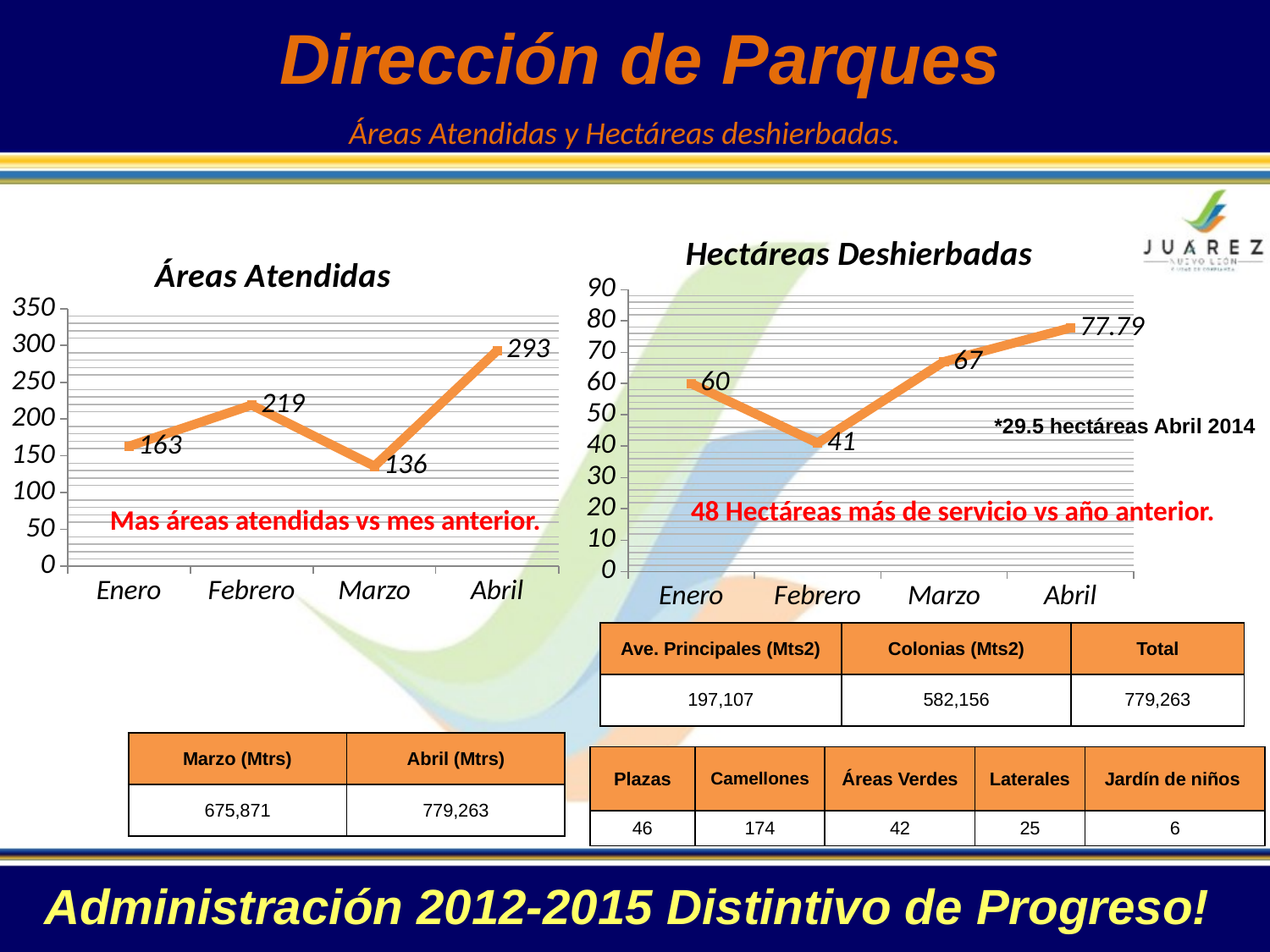
What kind of chart is the 'Áreas Atendidas' chart? Line chart In the 'Hectáreas Deshierbadas' chart, which is larger, the value for Enero or the value for Marzo? Marzo In the 'Áreas Atendidas' chart, which month has the highest value? Abril In the 'Áreas Atendidas' chart, what is the value for Marzo? 136 In the 'Áreas Atendidas' chart, which month has the lowest value? Marzo In the 'Áreas Atendidas' chart, how many months are plotted? 4 In the 'Hectáreas Deshierbadas' chart, what is the value for Abril? 77.79 In the 'Áreas Atendidas' chart, what is the difference between the values for Abril and Marzo? 157 In the 'Áreas Atendidas' chart, what is the value for Abril? 293 In the 'Hectáreas Deshierbadas' chart, what is the value for Febrero? 41 In the 'Hectáreas Deshierbadas' chart, what is the difference between the values for Marzo and Febrero? 26 In the 'Hectáreas Deshierbadas' chart, which month has the lowest value? Febrero